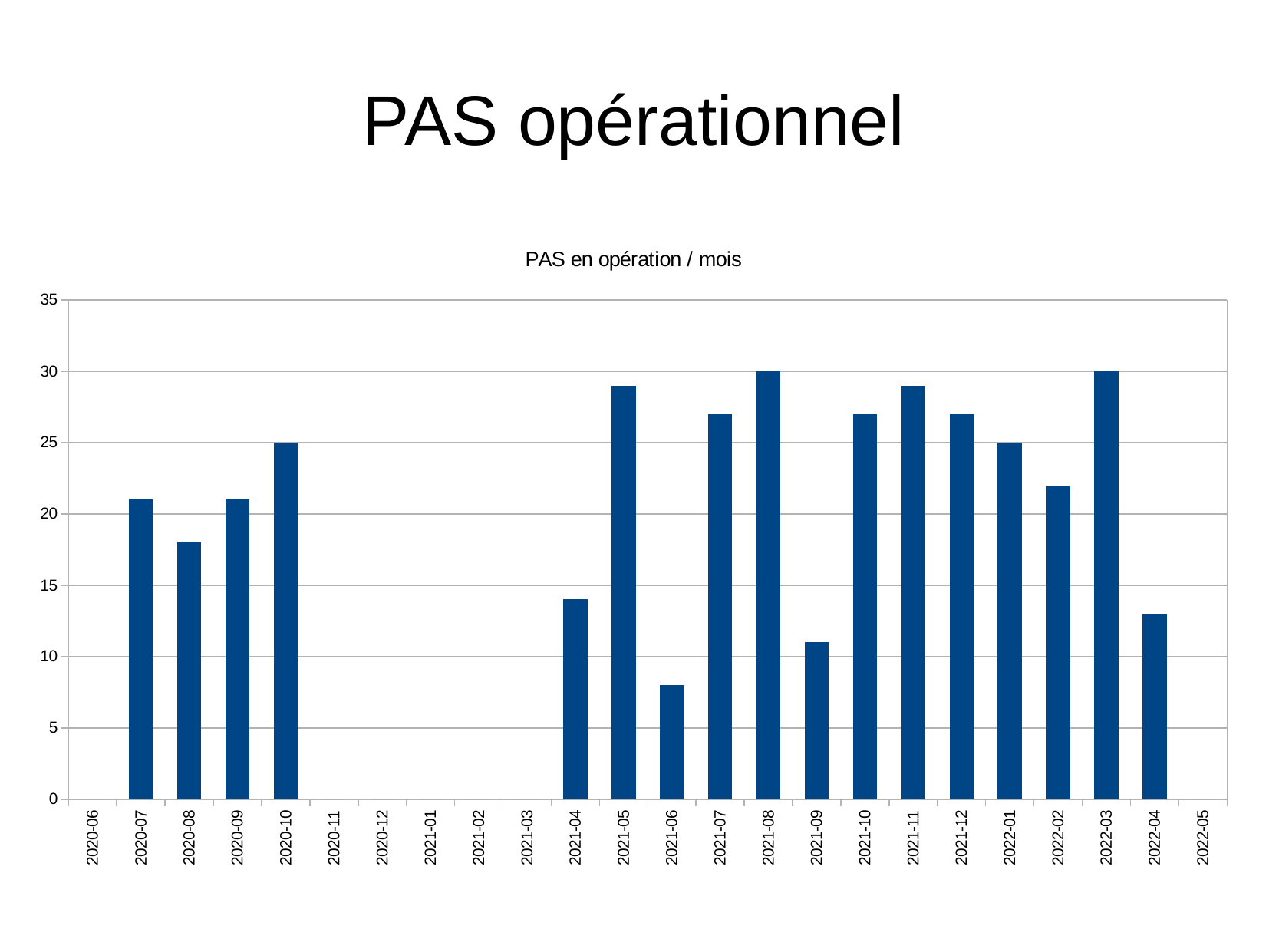
Which month has the lowest non-zero bar? 2021-06 What is the value for 2022-01? 25 Is the value for 2020-08 greater or less than 20? less Is the value for 2021-05 greater or less than 25? greater What is the title of the chart? PAS en opération / mois Is the value for 2021-06 greater or less than 10? less Which is larger, the value for 2021-04 or the value for 2021-05? 2021-05 What is the value for 2021-08? 30 What is the difference between the values for 2022-03 and 2022-01? 5 What kind of chart is shown on the slide? bar chart How many month labels are shown on the x axis? 24 What is the value for 2020-10? 25